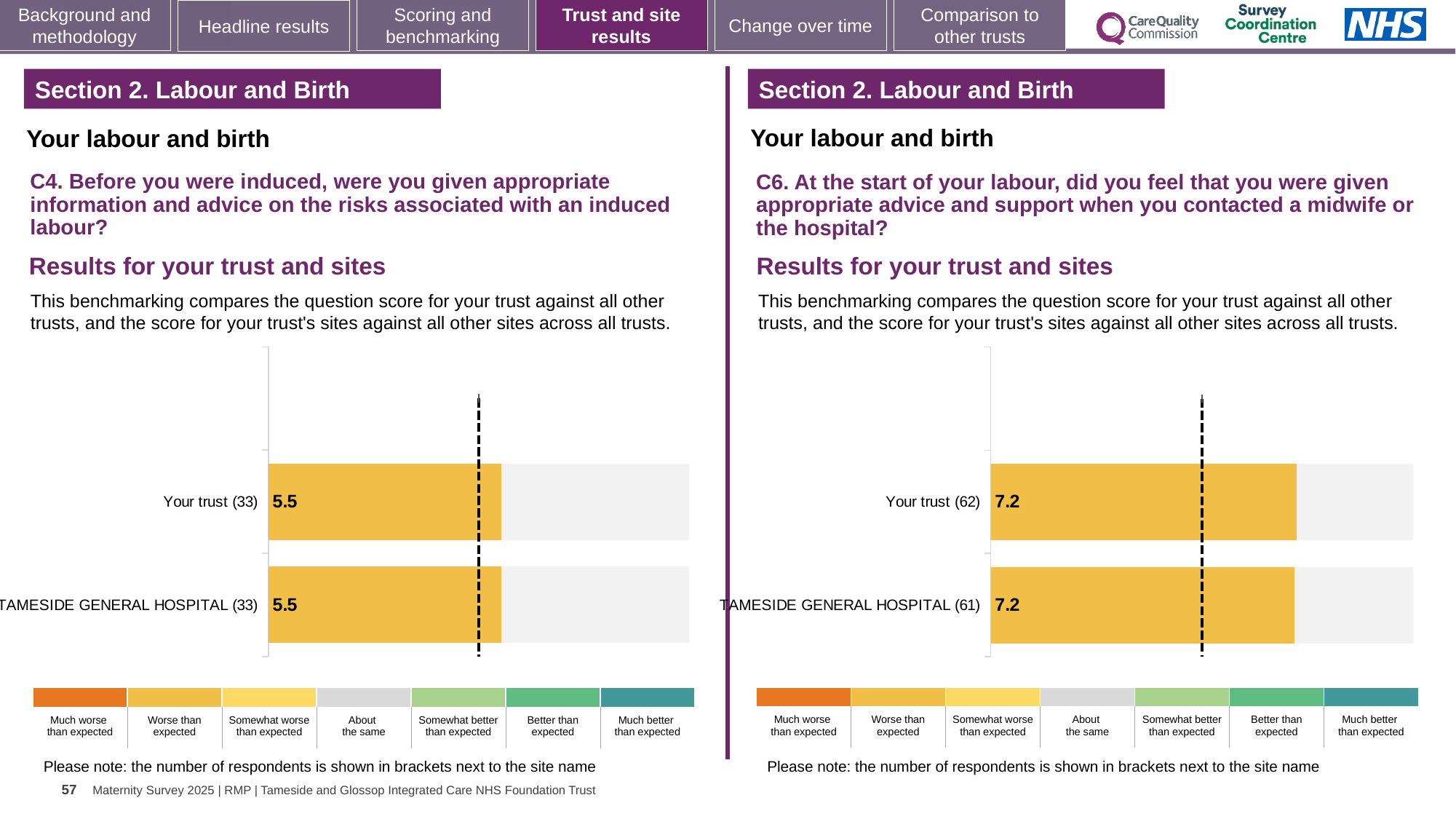
On the left chart (C4), what is the score for Your trust? 5.5 On the left chart (C4), how many respondents are shown in brackets for Your trust? 33 On the left chart (C4), what is the score for TAMESIDE GENERAL HOSPITAL? 5.5 On the right chart (C6), what is the difference between the Your trust score and the TAMESIDE GENERAL HOSPITAL score? 0 How many bars are plotted on the left chart (C4)? 2 Is the Your trust score on the right chart (C6) larger or smaller than the Your trust score on the left chart (C4)? Larger On the right chart (C6), what is the score for Your trust? 7.2 On the right chart (C6), what is the score for TAMESIDE GENERAL HOSPITAL? 7.2 On the left chart (C4), what is the difference between the Your trust score and the TAMESIDE GENERAL HOSPITAL score? 0 How many bars are plotted on the right chart (C6)? 2 What type of chart is used on the left (C4)? Bar chart On the right chart (C6), how many respondents are shown in brackets for TAMESIDE GENERAL HOSPITAL? 61